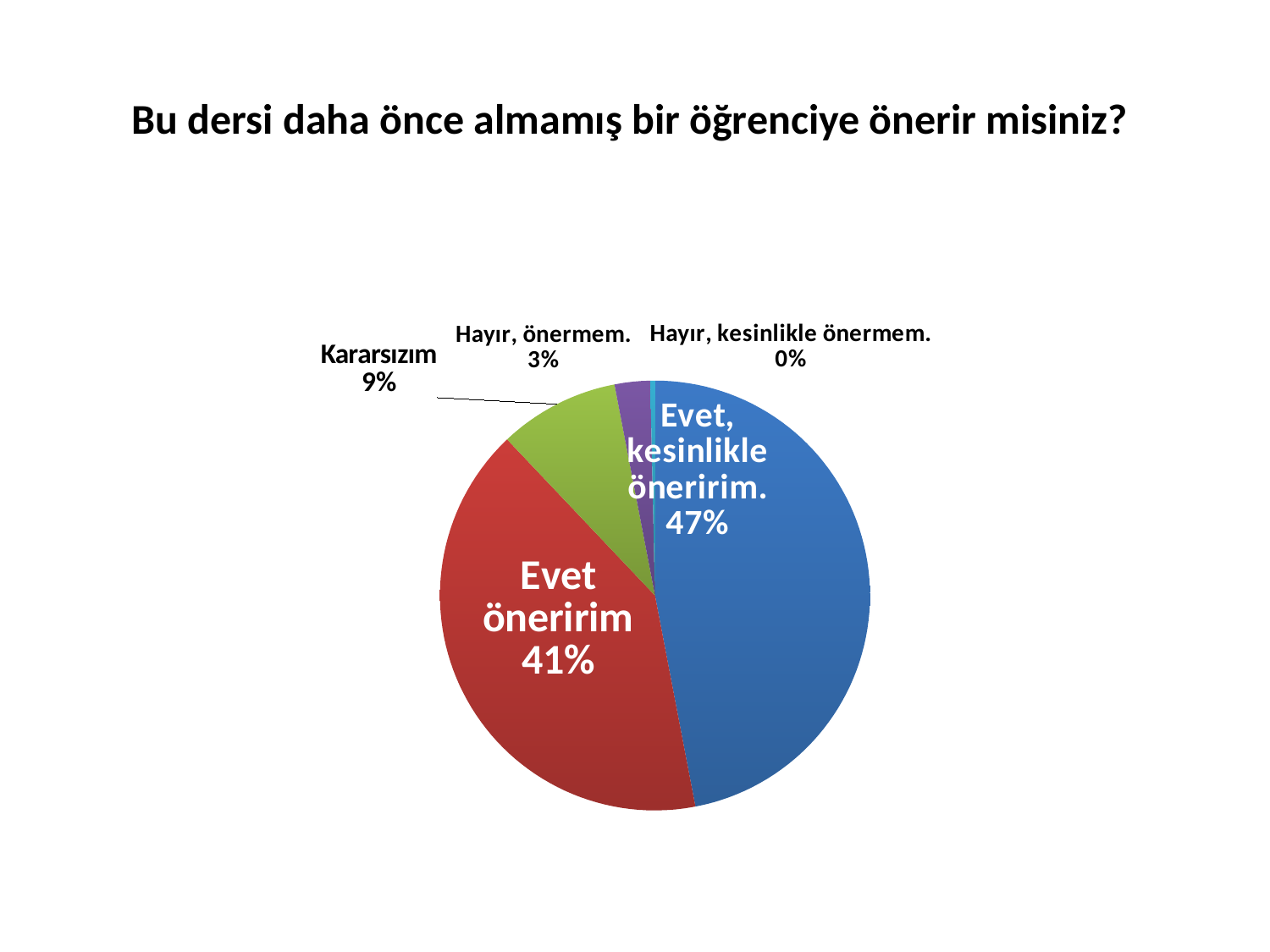
Which category has the largest slice of the pie? Evet, kesinlikle öneririm. What share of the pie is labelled "Hayır, önermem."? 3% What kind of chart is shown on the slide? pie chart What share of the pie is labelled "Hayır, kesinlikle önermem."? 0% How many categories are shown in the pie chart? 5 What share of the pie is labelled "Evet, kesinlikle öneririm."? 47% What is the title of the chart? Bu dersi daha önce almamış bir öğrenciye önerir misiniz? What share of the pie is labelled "Kararsızım"? 9% Which is larger, the share for "Kararsızım" or the share for "Hayır, önermem."? Kararsızım What is the difference in percentage points between "Evet, kesinlikle öneririm." and "Evet öneririm"? 6 Which category has the smallest slice of the pie? Hayır, kesinlikle önermem. What share of the pie is labelled "Evet öneririm"? 41%